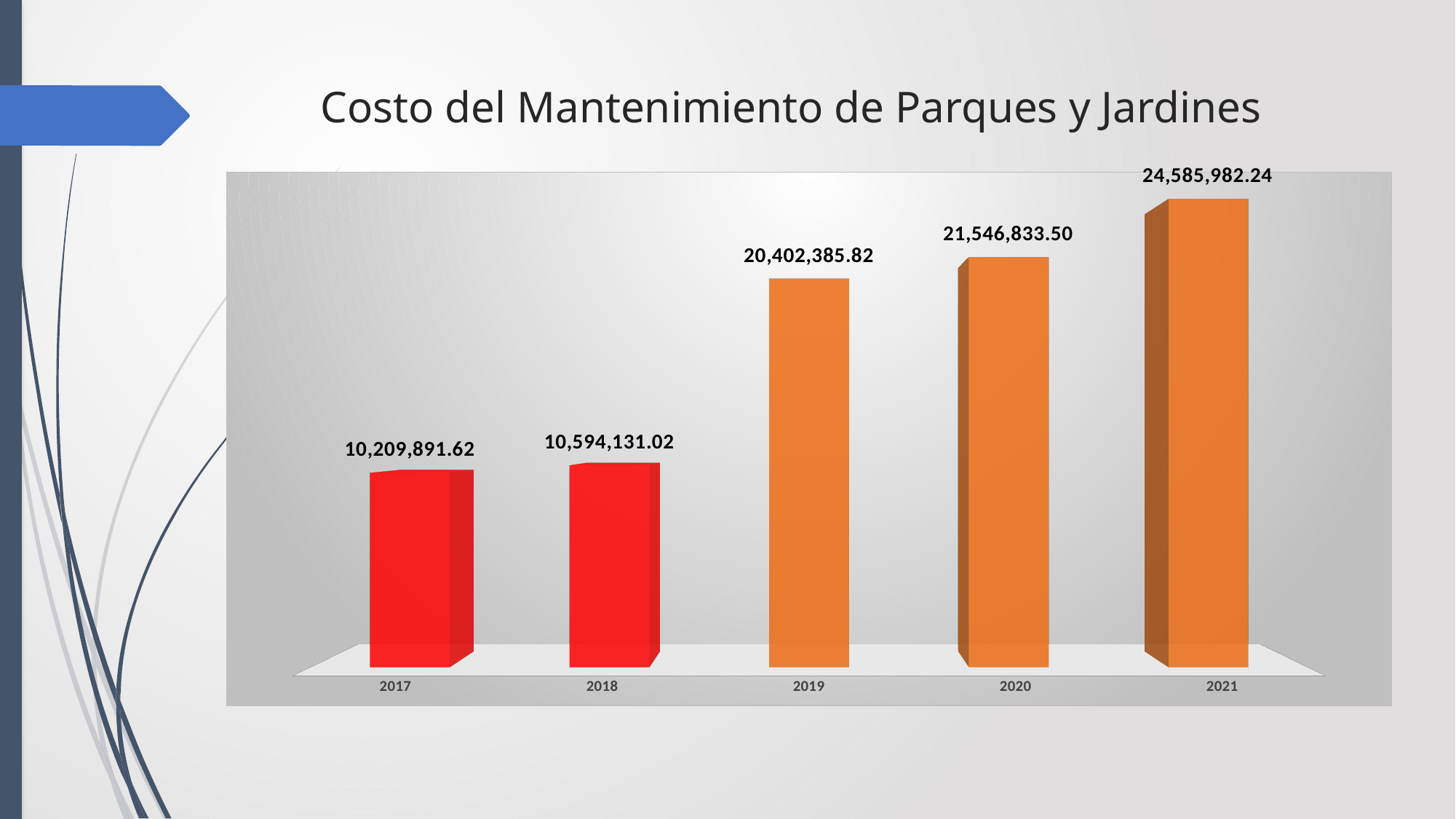
How many years are shown on the x axis? 5 What is the value for 2019? 20,402,385.82 What is the difference between the values for 2021 and 2020? 3,039,148.74 What is the title of the chart? Costo del Mantenimiento de Parques y Jardines What is the value for 2021? 24,585,982.24 Which is larger, the value for 2019 or the value for 2020? 2020 What is the difference between the values for 2018 and 2017? 384,239.40 What is the value for 2017? 10,209,891.62 What kind of chart is shown on the slide? Bar chart Which year has the highest value? 2021 Do the values rise or fall from 2017 to 2021? Rise Which year has the lowest value? 2017